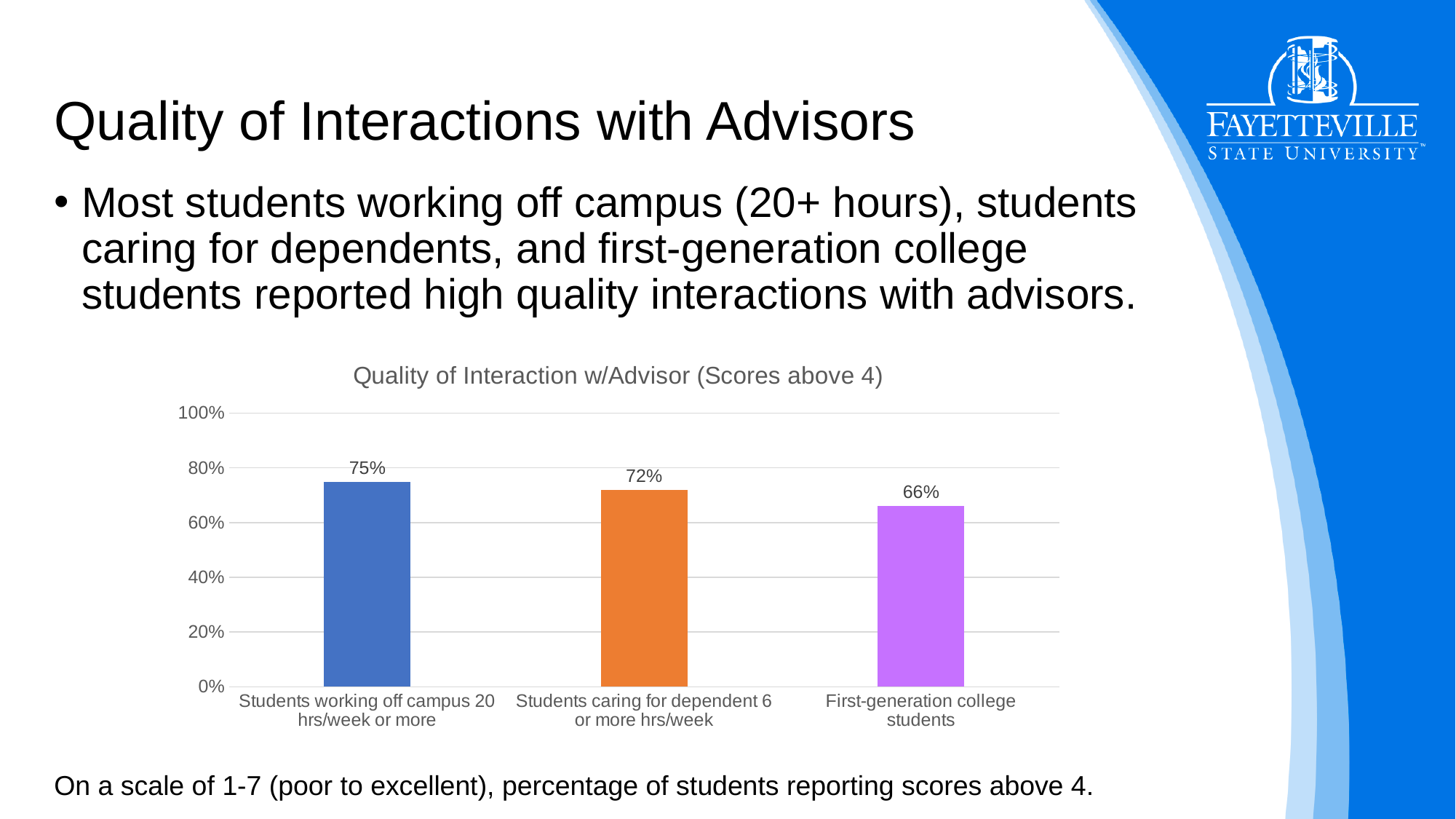
Which is larger: the value for Students working off campus 20 hrs/week or more or the value for Students caring for dependent 6 or more hrs/week? Students working off campus 20 hrs/week or more What is the value for Students caring for dependent 6 or more hrs/week? 72% What is the value for Students working off campus 20 hrs/week or more? 75% What is the value for First-generation college students? 66% What kind of chart is shown on the slide? Bar chart What is the difference between the values for Students working off campus 20 hrs/week or more and First-generation college students? 9% Is the value for First-generation college students greater or less than 80%? less Which category has the lowest value? First-generation college students What is the difference between the values for Students caring for dependent 6 or more hrs/week and First-generation college students? 6% Which category has the highest value? Students working off campus 20 hrs/week or more What is the title of the chart? Quality of Interaction w/Advisor (Scores above 4) How many categories are shown in the chart? 3